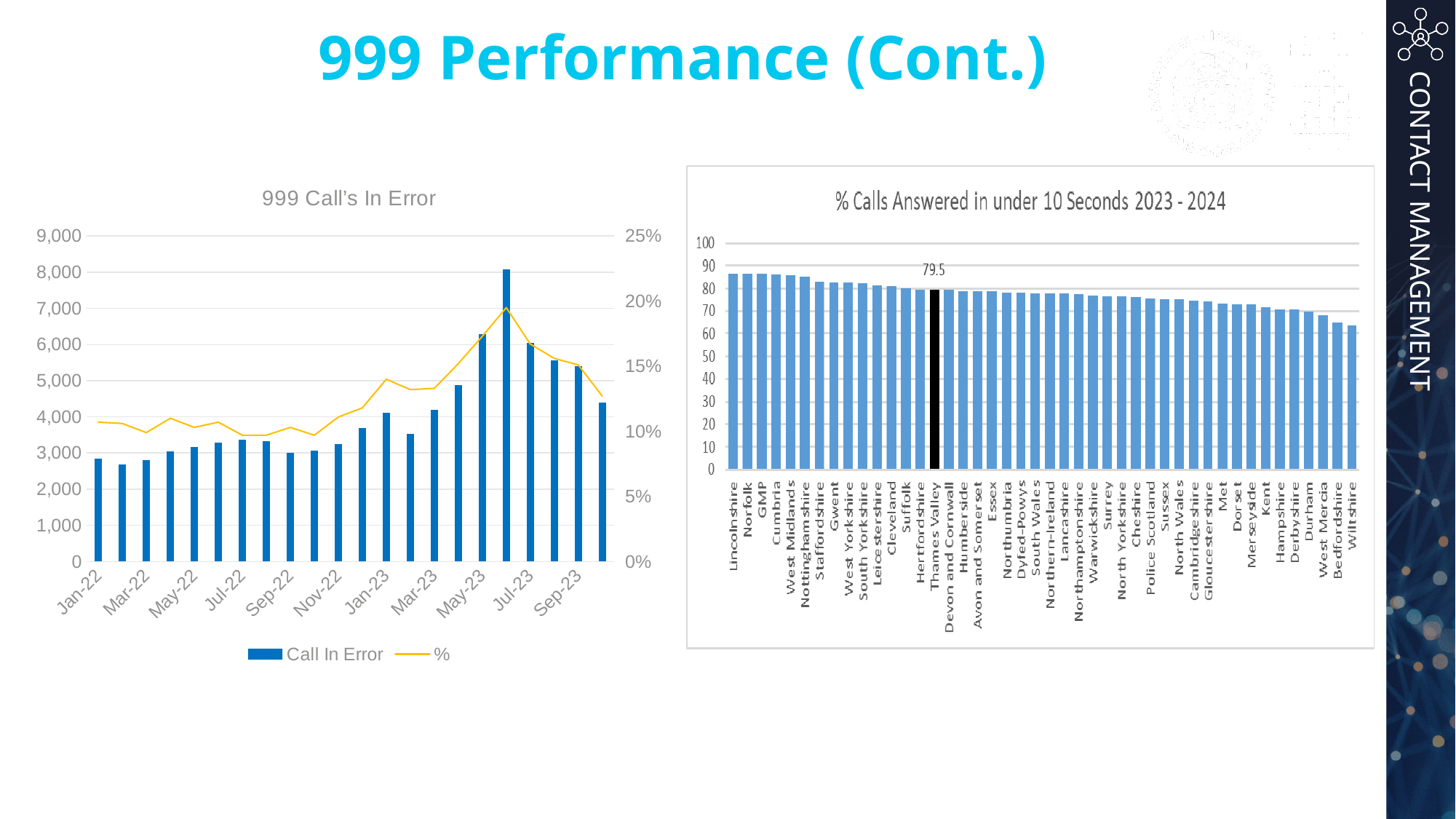
In the '% Calls Answered in under 10 Seconds 2023 - 2024' chart, is the value for Wiltshire greater or less than 70? less In the '999 Call's In Error' chart, is the number of calls in error for Jan-22 greater or less than 3,000? less In the '999 Call's In Error' chart, which month has the highest number of calls in error? Jun-23 How many series does the legend of the '999 Call's In Error' chart list? 2 In the '999 Call's In Error' chart, which is larger, the number of calls in error for Jul-23 or for Sep-23? Jul-23 What are the two legend entries in the '999 Call's In Error' chart? Call In Error and % What kind of chart is the '% Calls Answered in under 10 Seconds 2023 - 2024' chart? bar chart In the '% Calls Answered in under 10 Seconds 2023 - 2024' chart, is the value for Lincolnshire greater or less than 80? greater In the '% Calls Answered in under 10 Seconds 2023 - 2024' chart, which is larger, the value for Lincolnshire or the value for Wiltshire? Lincolnshire In the '% Calls Answered in under 10 Seconds 2023 - 2024' chart, what value is labelled for Thames Valley? 79.5 In the '% Calls Answered in under 10 Seconds 2023 - 2024' chart, do the values generally rise or fall from left to right? fall